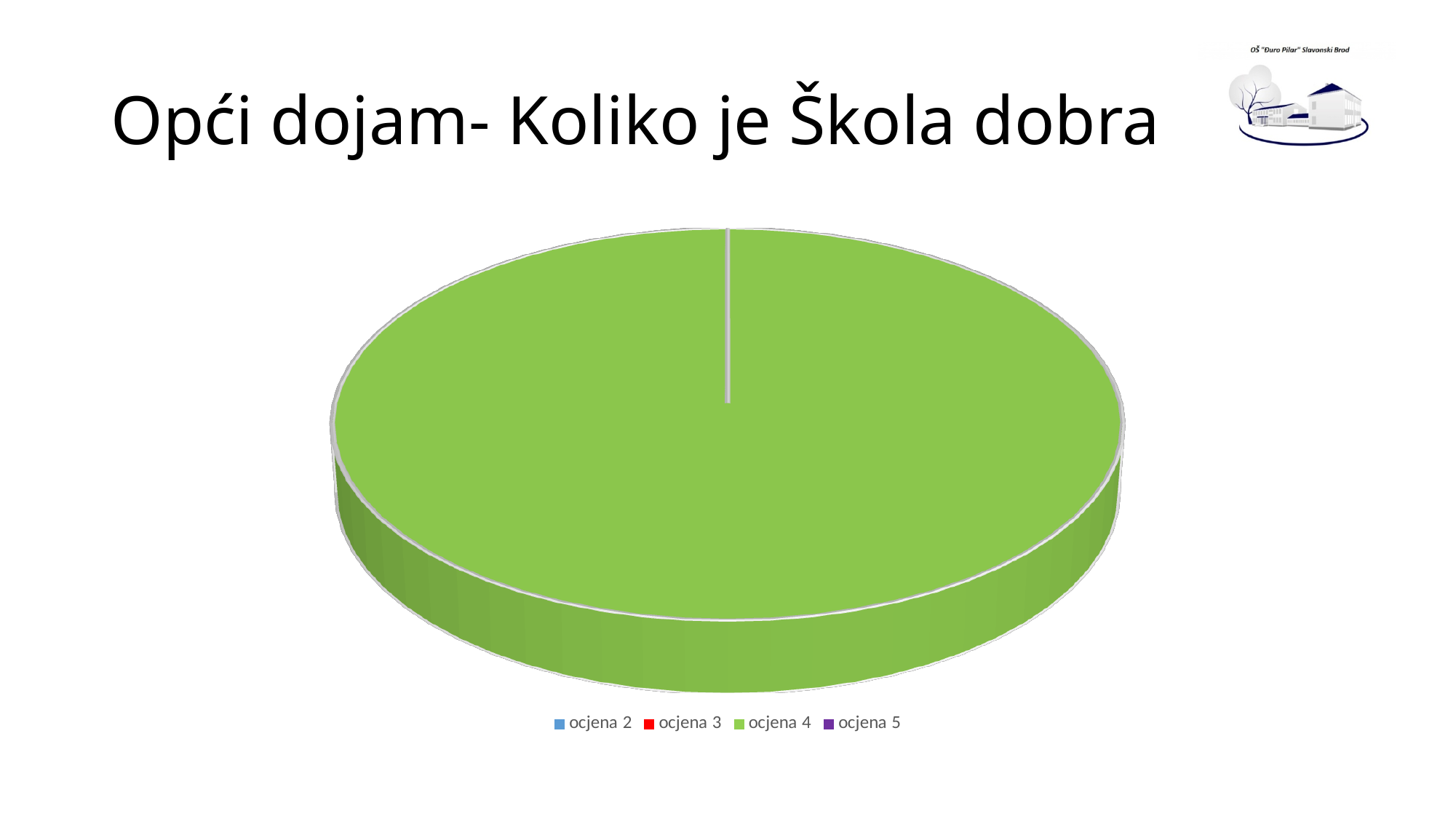
What kind of chart is shown on the slide? pie chart How many categories does the legend of the pie chart list? 4 What is the title of the slide containing the pie chart? Opći dojam- Koliko je Škola dobra Which category has the largest slice in the pie chart? ocjena 4 Which is larger in the pie chart, ocjena 3 or ocjena 4? ocjena 4 Which is larger in the pie chart, ocjena 4 or ocjena 2? ocjena 4 What colour represents ocjena 4 in the pie chart? green